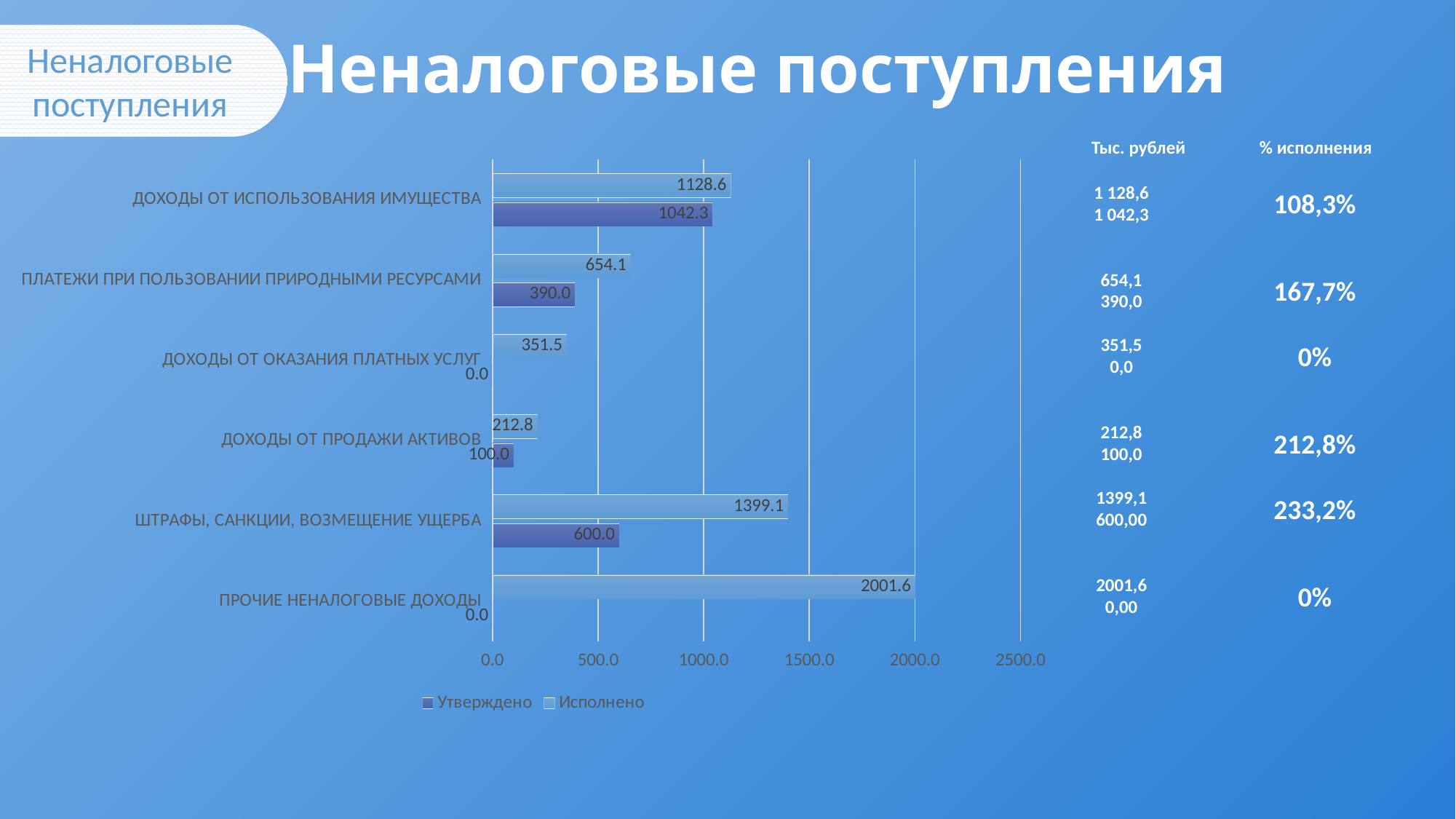
What is the Утверждено value for ПЛАТЕЖИ ПРИ ПОЛЬЗОВАНИИ ПРИРОДНЫМИ РЕСУРСАМИ? 390.0 Which category has the highest Исполнено value? ПРОЧИЕ НЕНАЛОГОВЫЕ ДОХОДЫ How many series does the legend list? 2 Which category has the lowest Исполнено value? ДОХОДЫ ОТ ПРОДАЖИ АКТИВОВ Which category has the highest Утверждено value? ДОХОДЫ ОТ ИСПОЛЬЗОВАНИЯ ИМУЩЕСТВА What is the difference between the Исполнено and Утверждено values for ШТРАФЫ, САНКЦИИ, ВОЗМЕЩЕНИЕ УЩЕРБА? 799.1 Which is larger for ДОХОДЫ ОТ ИСПОЛЬЗОВАНИЯ ИМУЩЕСТВА: the Утверждено value or the Исполнено value? Исполнено Is the Исполнено value for ПРОЧИЕ НЕНАЛОГОВЫЕ ДОХОДЫ greater or less than 1500.0? greater How many categories are shown on the chart? 6 What is the Утверждено value for ДОХОДЫ ОТ ОКАЗАНИЯ ПЛАТНЫХ УСЛУГ? 0.0 What kind of chart is shown on the slide? bar chart What is the Исполнено value for ДОХОДЫ ОТ ИСПОЛЬЗОВАНИЯ ИМУЩЕСТВА? 1128.6